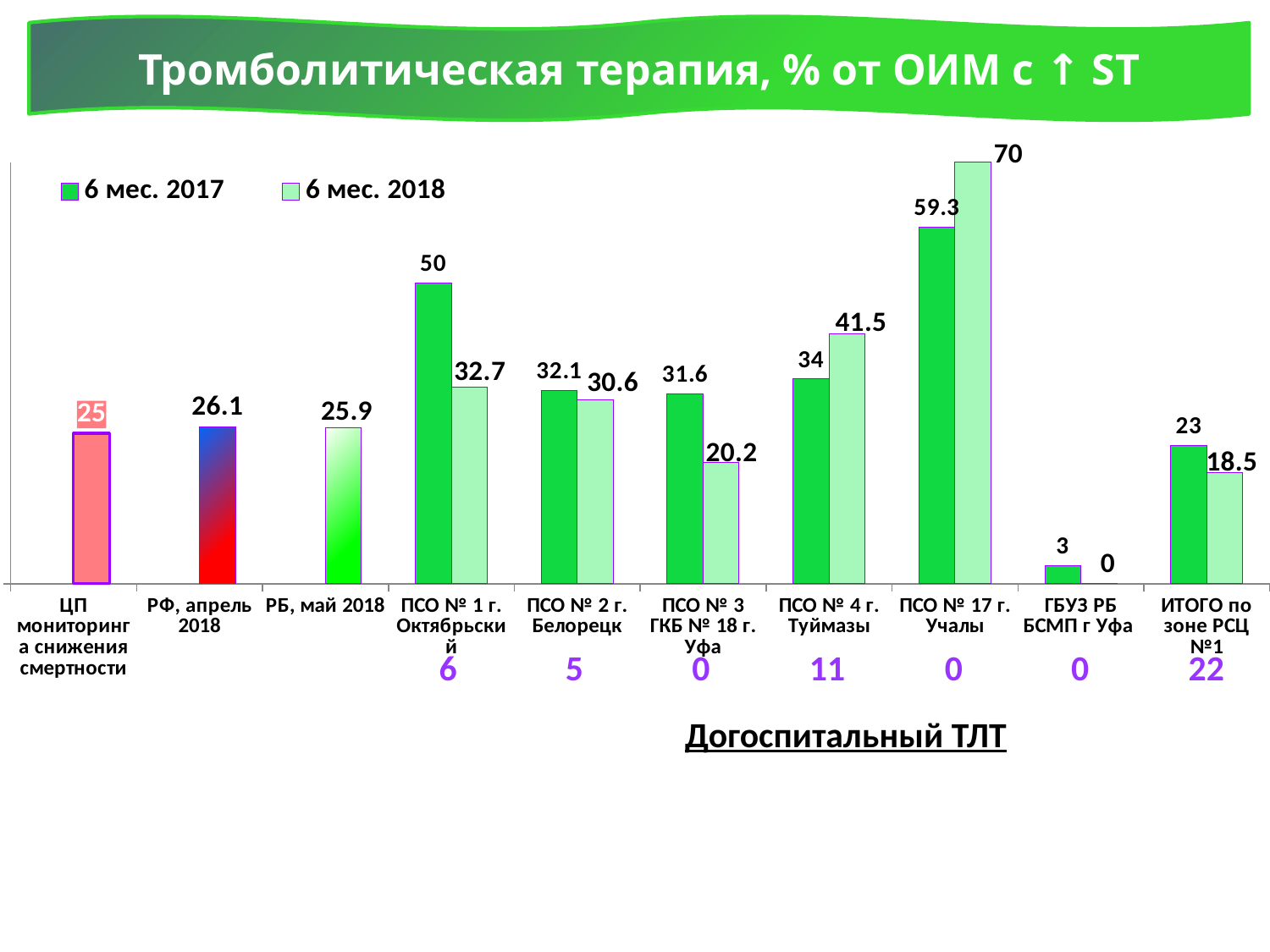
How many categories are shown on the x axis? 10 What kind of chart is shown on the slide? bar chart What is the value for ПСО № 1 г. Октябрьский in the 6 мес. 2017 series? 50 For ПСО № 4 г. Туймазы, which is larger: the 6 мес. 2017 value or the 6 мес. 2018 value? 6 мес. 2018 Which category has the lowest value in the 6 мес. 2017 series? ГБУЗ РБ БСМП г Уфа What is the value for ПСО № 17 г. Учалы in the 6 мес. 2018 series? 70 What is the value for РФ, апрель 2018? 26.1 Which category has the highest value in the 6 мес. 2018 series? ПСО № 17 г. Учалы What is the value for ПСО № 3 ГКБ № 18 г. Уфа in the 6 мес. 2018 series? 20.2 What is the title of the chart? Тромболитическая терапия, % от ОИМ с ↑ ST What is the difference between the 6 мес. 2017 and 6 мес. 2018 values for ПСО № 1 г. Октябрьский? 17.3 How many series does the legend list? 2